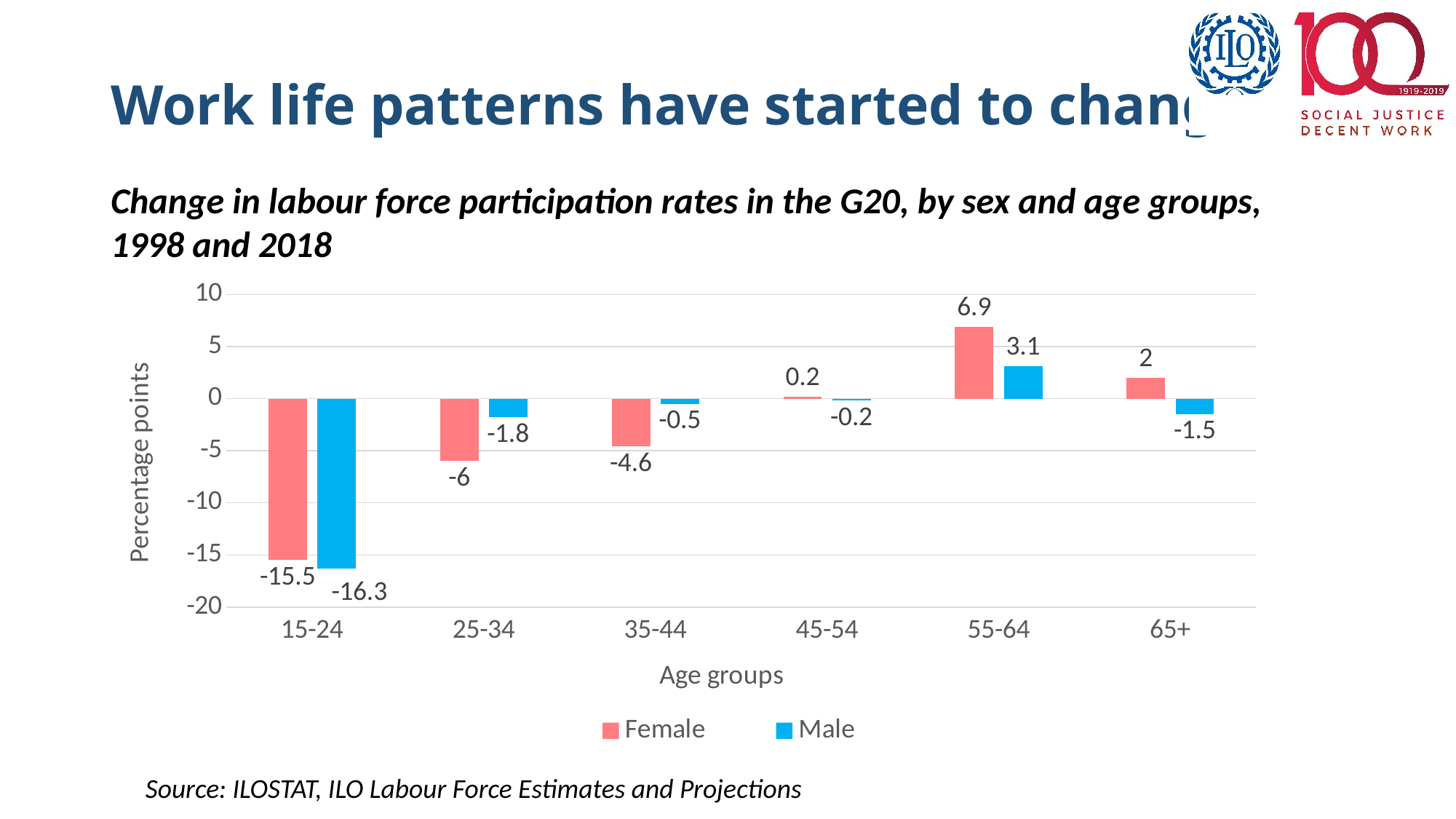
What is the Female value for the 45-54 age group? 0.2 How many series does the legend list? 2 What is the Female value for the 15-24 age group? -15.5 What is the Male value for the 55-64 age group? 3.1 What is the difference between the Female and Male values for the 25-34 age group? 4.2 What is the label of the vertical axis? Percentage points How many age groups are shown on the x axis? 6 What kind of chart is shown on the slide? Bar chart Which is larger for the 35-44 age group, the Female value or the Male value? Male What is the Male value for the 65+ age group? -1.5 Which age group has the lowest Male value? 15-24 Which age group has the highest Female value? 55-64